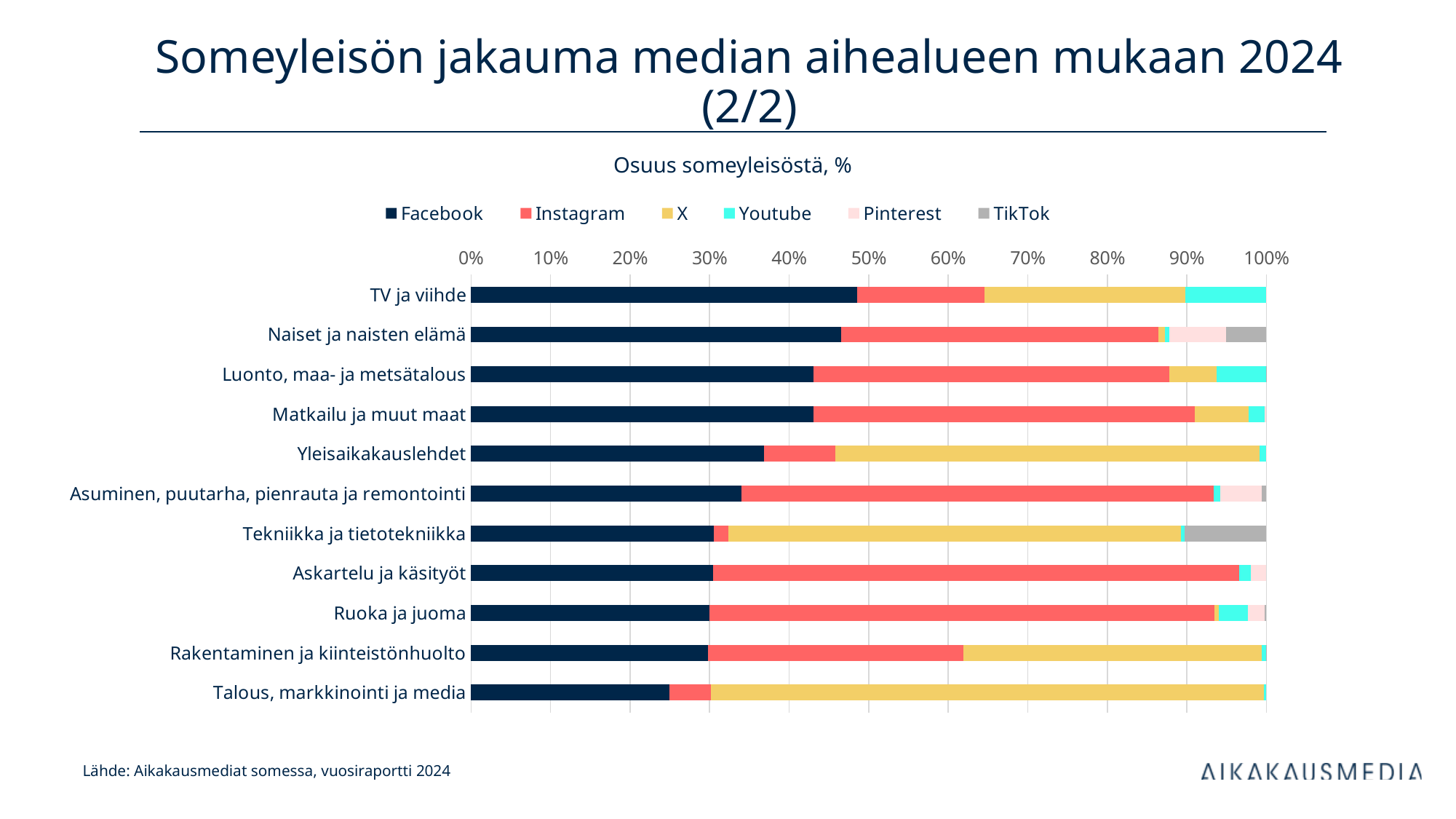
Which category has the largest X share? Talous, markkinointi ja media Is the Facebook share for Talous, markkinointi ja media greater or less than 30%? less What is the axis title shown above the legend? Osuus someyleisöstä, % Which category has the largest TikTok share? Tekniikka ja tietotekniikka How many categories (media topic areas) are listed on the chart? 11 Which is larger: the Facebook share for TV ja viihde or for Talous, markkinointi ja media? TV ja viihde How many series does the legend list? 6 Is the Facebook share for Yleisaikakauslehdet greater or less than 30%? greater Which category has the smallest Facebook share? Talous, markkinointi ja media What kind of chart is shown on the slide? Stacked bar chart Which is larger: the Instagram share for Askartelu ja käsityöt or for Tekniikka ja tietotekniikka? Askartelu ja käsityöt Is the Facebook share for TV ja viihde greater or less than 40%? greater